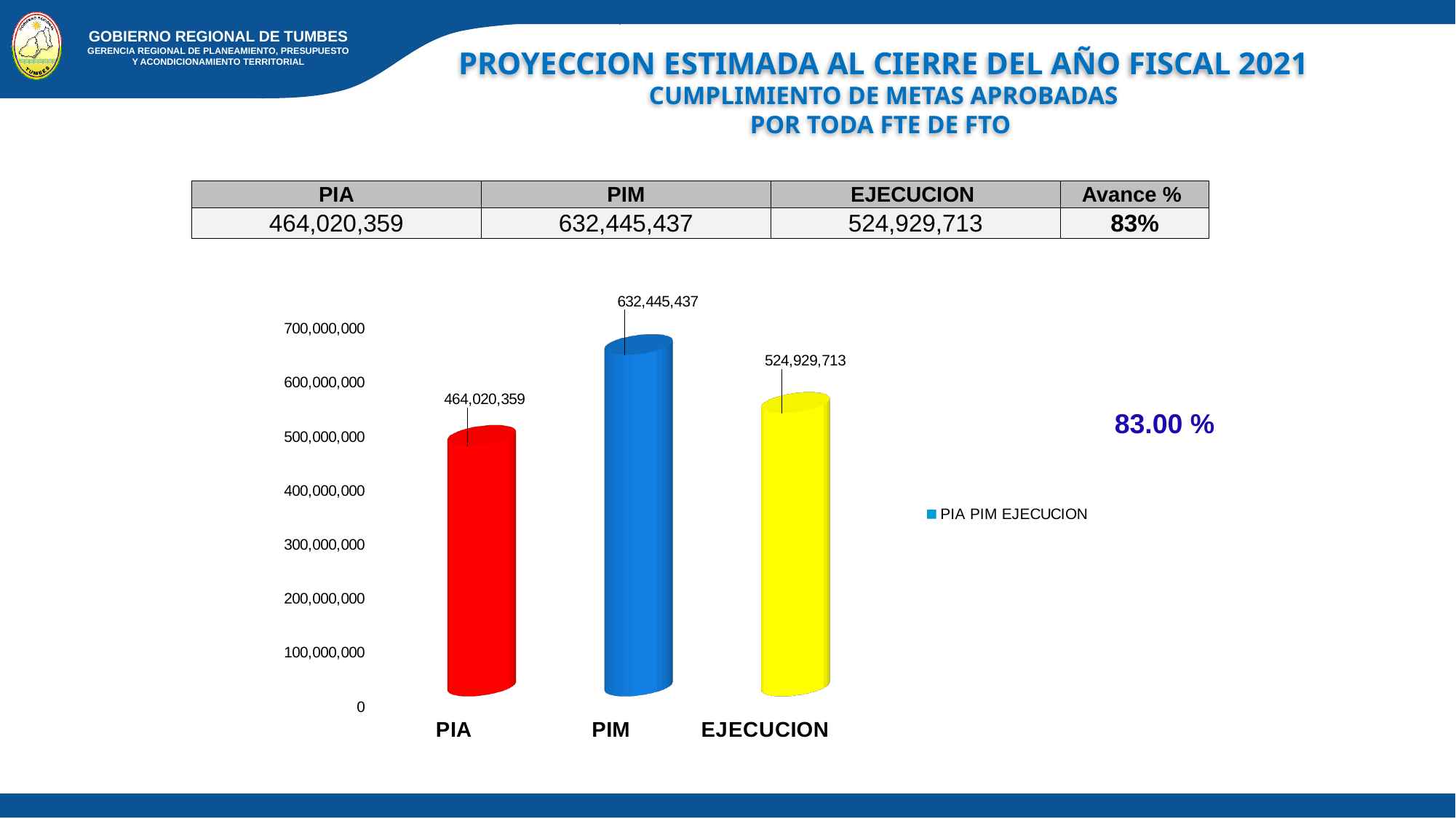
What colour is the PIM bar? blue Is the value for PIA greater or less than 500,000,000? less What is the difference between the PIM and PIA values? 168,425,078 What is the value of the PIA bar? 464,020,359 Which is larger, the EJECUCION value or the PIA value? EJECUCION What is the difference between the PIM and EJECUCION values? 107,515,724 Which category has the lowest value? PIA What is the value of the EJECUCION bar? 524,929,713 Which category has the highest value? PIM How many bars are plotted in the chart? 3 What kind of chart is shown on the slide? bar chart What is the value of the PIM bar? 632,445,437